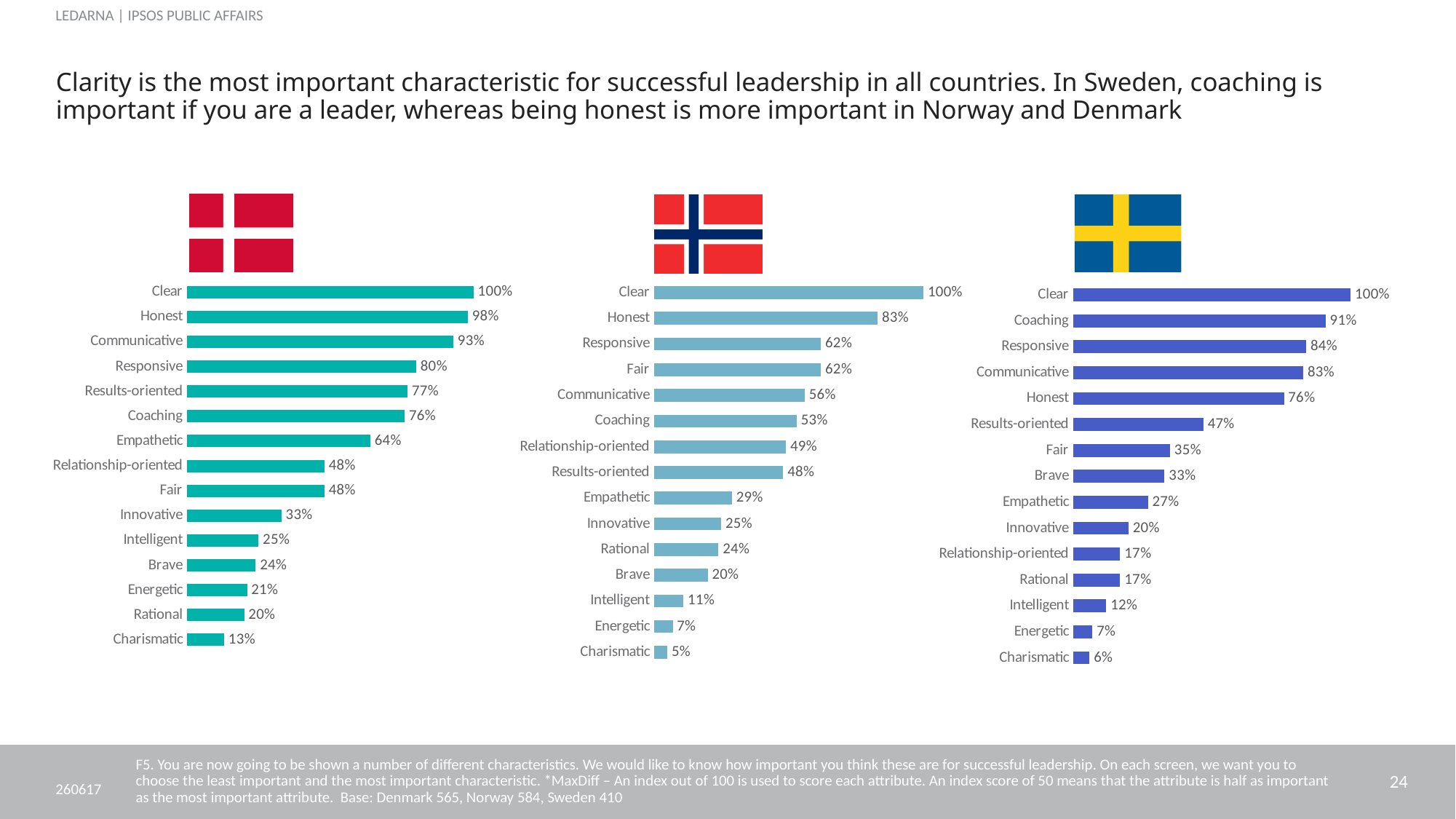
In the right chart (Swedish flag), what is the difference between Honest and Results-oriented? 29% In the left chart (Danish flag), what is the difference between Honest and Coaching? 22% In the middle chart (Norwegian flag), what is the value for Coaching? 53% What colour are the bars in the left chart (Danish flag)? Teal In the middle chart (Norwegian flag), which characteristic has the highest value? Clear In the right chart (Swedish flag), which characteristic has the lowest value? Charismatic In the middle chart (Norwegian flag), what is the value for Intelligent? 11% How many characteristics are plotted in the left chart (Danish flag)? 15 In the left chart (Danish flag), what is the value for Communicative? 93% What type of chart is used in the right chart (Swedish flag)? Bar chart In the right chart (Swedish flag), what is the value for Coaching? 91% In the middle chart (Norwegian flag), which is larger, Empathetic or Innovative? Empathetic